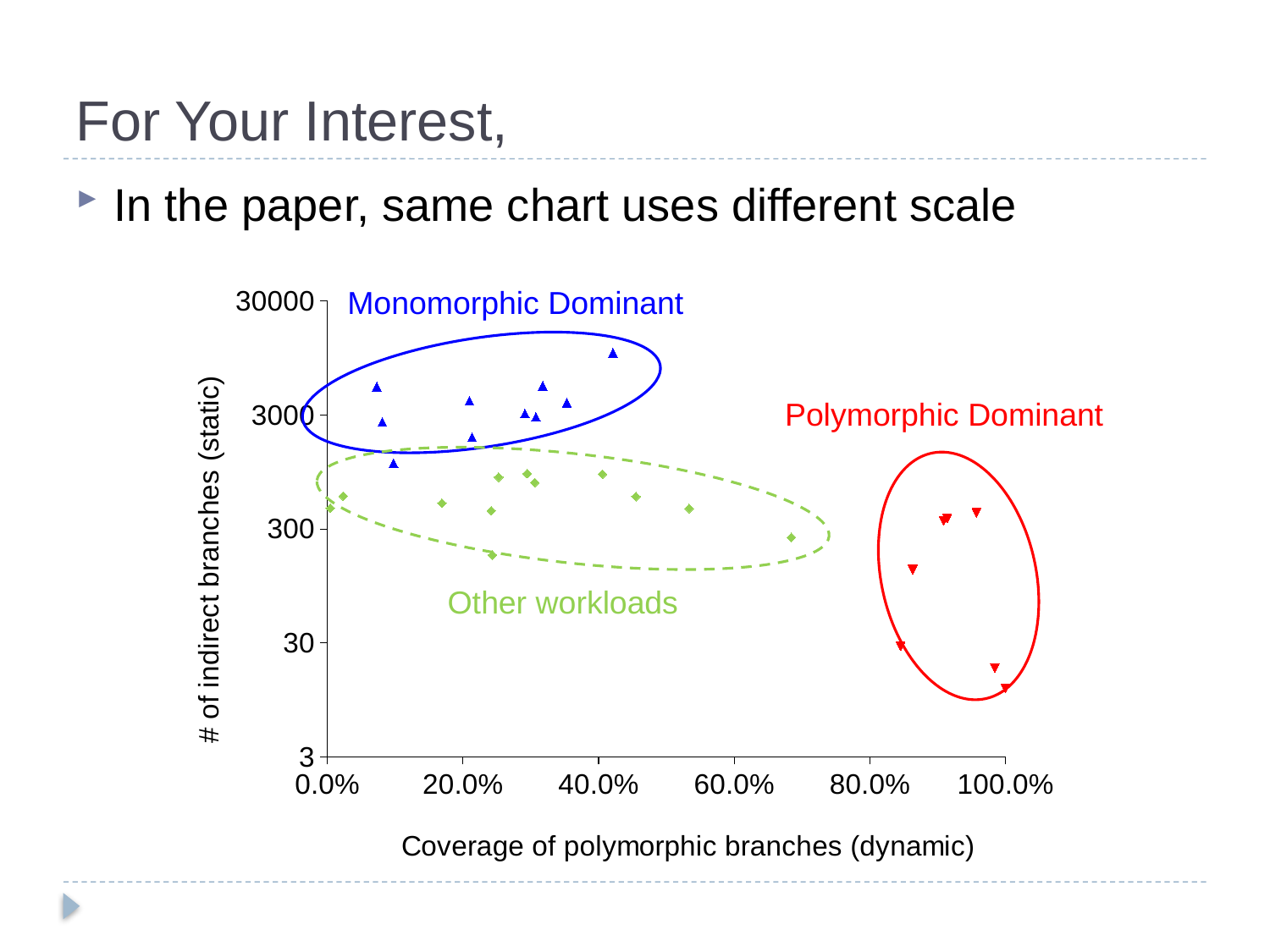
What is the highest value shown on the y axis of the chart? 30000 What is the label of the y axis of the chart? # of indirect branches (static) Which group has more indirect branches overall, Monomorphic Dominant or Polymorphic Dominant? Monomorphic Dominant How many labelled groups of workloads are circled on the chart? 3 What is the label of the x axis of the chart? Coverage of polymorphic branches (dynamic) Are the coverage values for the Polymorphic Dominant points greater or less than 80.0%? greater Which group of points has the highest coverage of polymorphic branches? Polymorphic Dominant Are the numbers of indirect branches for the Polymorphic Dominant points greater or less than 3000? less Are the coverage values for the Monomorphic Dominant points greater or less than 60.0%? less Which group contains the point with the highest number of indirect branches? Monomorphic Dominant What kind of chart is shown on the slide? scatter chart